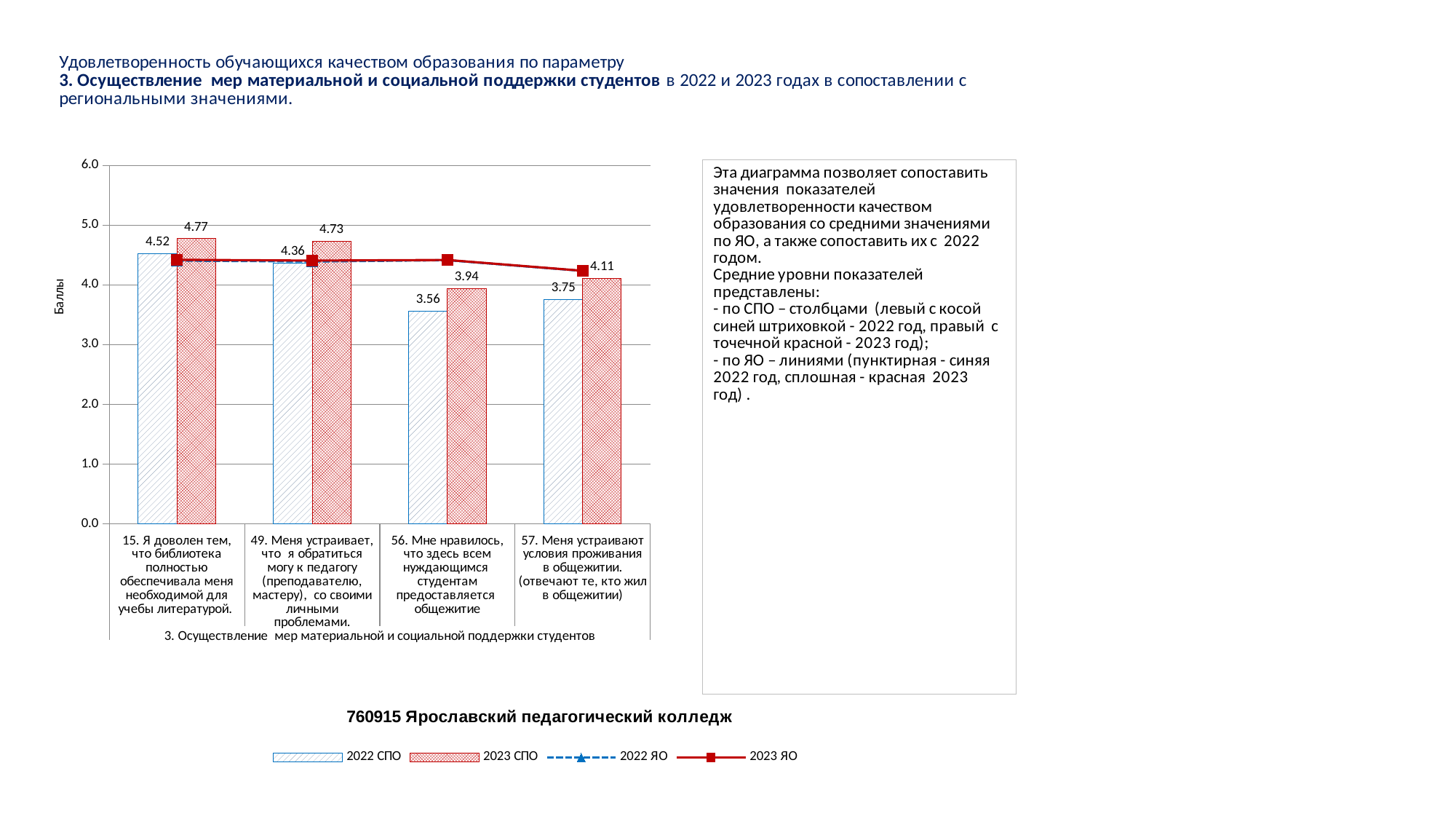
Which question has the lowest 2022 СПО value? 56. Мне нравилось, что здесь всем нуждающимся студентам предоставляется общежитие Is the 2023 ЯО line value for question 57 greater or less than 4.0? greater Which is larger: the 2022 СПО value for question 15 or for question 49? Question 15 What is the 2022 СПО value for question 56 (Мне нравилось, что здесь всем нуждающимся студентам предоставляется общежитие)? 3.56 Which question has the highest 2023 СПО value? 15. Я доволен тем, что библиотека полностью обеспечивала меня необходимой для учебы литературой By how much did the СПО value for question 57 increase from 2022 to 2023? 0.36 What is the difference between the 2023 СПО values for question 15 and question 56? 0.83 What is the 2022 СПО value for question 49 (Меня устраивает, что я могу обратиться к педагогу со своими личными проблемами)? 4.36 How many questions (categories) are shown on the x axis? 4 How many series does the legend list? 4 What is the 2023 СПО value for question 15 (Я доволен тем, что библиотека полностью обеспечивала меня необходимой для учебы литературой)? 4.77